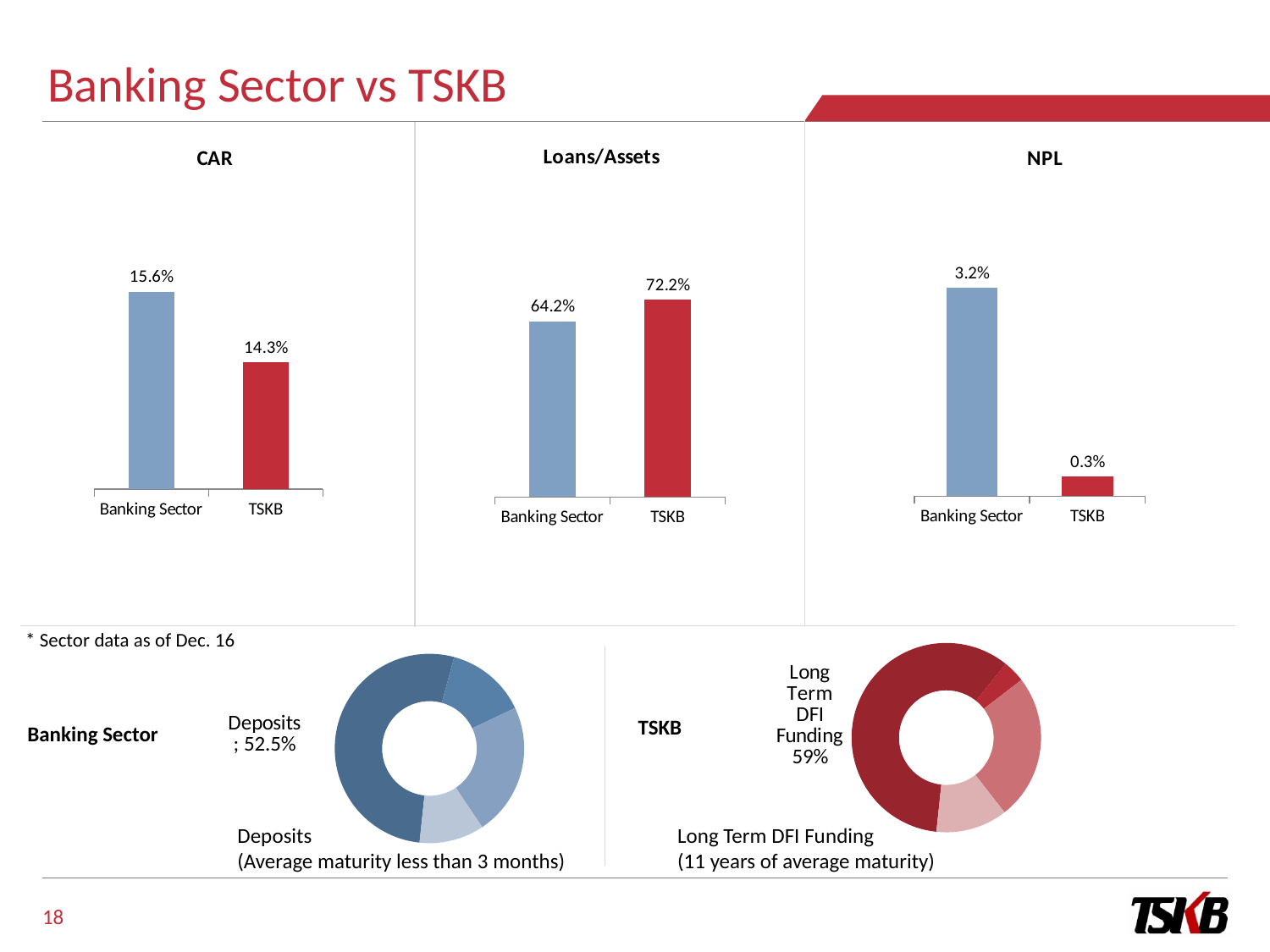
In the CAR chart, what is the value for Banking Sector? 15.6% In the Loans/Assets chart, what is the value for TSKB? 72.2% In the NPL chart, which category has the lower value? TSKB In the CAR chart, is the value for Banking Sector larger or smaller than the value for TSKB? larger In the Banking Sector donut chart at the bottom left, what share is labelled for Deposits? 52.5% In the CAR chart, what is the value for TSKB? 14.3% In the TSKB donut chart at the bottom right, what share is labelled for Long Term DFI Funding? 59% In the Loans/Assets chart, what is the difference between the TSKB value and the Banking Sector value? 8.0 percentage points In the NPL chart, what is the value for TSKB? 0.3% In the Loans/Assets chart, which category has the higher value? TSKB In the NPL chart, what is the value for Banking Sector? 3.2% In the CAR chart, what is the difference between the Banking Sector value and the TSKB value? 1.3 percentage points